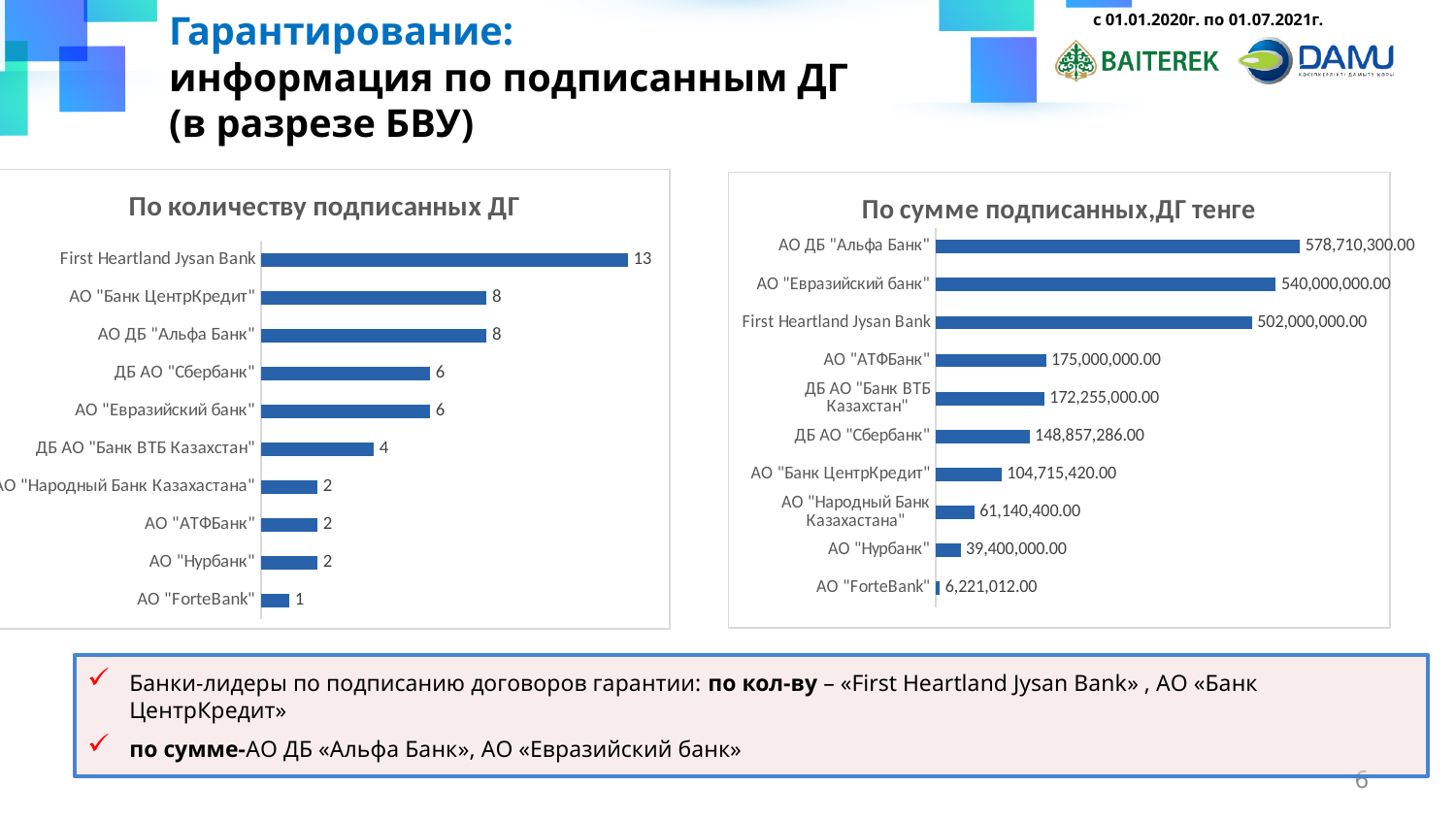
In the chart "По количеству подписанных ДГ", what is the value for ДБ АО "Банк ВТБ Казахстан"? 4 In the chart "По сумме подписанных,ДГ тенге", what is the difference between АО ДБ "Альфа Банк" and АО "Евразийский банк"? 38,710,300.00 In the chart "По количеству подписанных ДГ", what is the value for First Heartland Jysan Bank? 13 In the chart "По сумме подписанных,ДГ тенге", what is the value for АО ДБ "Альфа Банк"? 578,710,300.00 What is the title of the chart on the left side of the slide? По количеству подписанных ДГ What type of chart is "По сумме подписанных,ДГ тенге"? Bar chart In the chart "По количеству подписанных ДГ", how many banks are shown? 10 In the chart "По сумме подписанных,ДГ тенге", which is larger: АО "АТФБанк" or ДБ АО "Сбербанк"? АО "АТФБанк" In the chart "По сумме подписанных,ДГ тенге", which bank has the highest value? АО ДБ "Альфа Банк" In the chart "По сумме подписанных,ДГ тенге", what is the value for АО "ForteBank"? 6,221,012.00 In the chart "По количеству подписанных ДГ", what is the difference between First Heartland Jysan Bank and АО "Банк ЦентрКредит"? 5 In the chart "По количеству подписанных ДГ", which bank has the lowest value? АО "ForteBank"